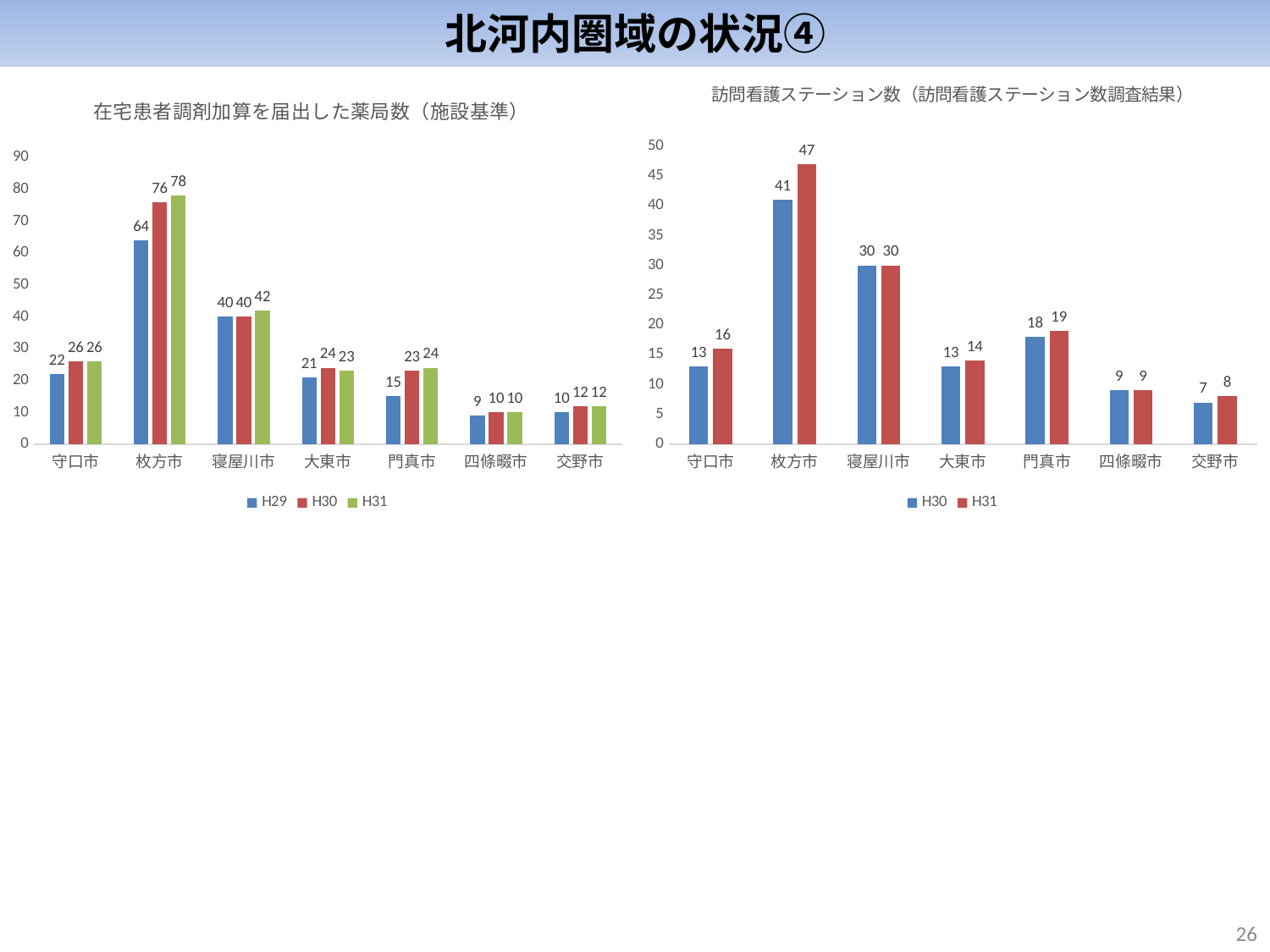
What kind of chart is the right chart (訪問看護ステーション数)? Bar chart In the left chart (在宅患者調剤加算を届出した薬局数), how many series does the legend list? 3 In the right chart (訪問看護ステーション数), what is the H30 value for 交野市? 7 In the right chart (訪問看護ステーション数), which city has the lowest H31 value? 交野市 In the right chart (訪問看護ステーション数), what is the H31 value for 枚方市? 47 In the left chart (在宅患者調剤加算を届出した薬局数), what is the H31 value for 枚方市? 78 In the left chart (在宅患者調剤加算を届出した薬局数), which city has the lowest H29 value? 四條畷市 In the left chart (在宅患者調剤加算を届出した薬局数), what is the difference between the H31 and H29 values for 枚方市? 14 In the left chart (在宅患者調剤加算を届出した薬局数), what is the H29 value for 門真市? 15 In the left chart (在宅患者調剤加算を届出した薬局数), which city has the highest H30 value? 枚方市 In the right chart (訪問看護ステーション数), how many cities are shown on the x axis? 7 In the right chart (訪問看護ステーション数), is the H30 value for 寝屋川市 larger or the H30 value for 門真市? 寝屋川市